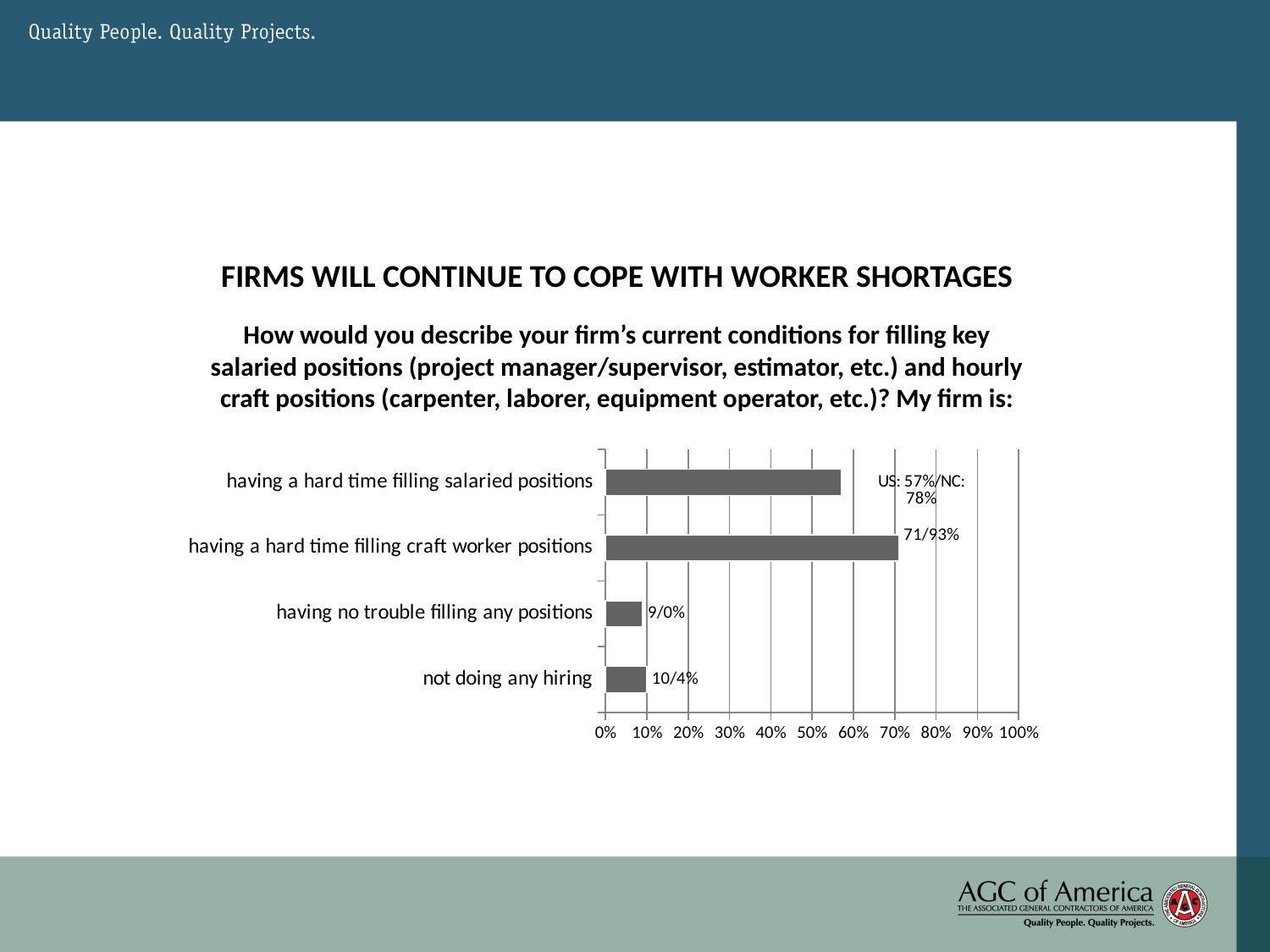
What is the highest value shown on the x axis of the chart? 100% Which bar is longer: 'having a hard time filling salaried positions' or 'having a hard time filling craft worker positions'? having a hard time filling craft worker positions What data label is shown for 'not doing any hiring'? 10/4% What data label is shown for 'having a hard time filling salaried positions'? US: 57%/NC: 78% What is the difference between the US values for 'having a hard time filling craft worker positions' (71%) and 'having a hard time filling salaried positions' (57%)? 14% What kind of chart is shown on the slide? bar chart Which category has the longest bar in the chart? having a hard time filling craft worker positions What data label is shown for 'having no trouble filling any positions'? 9/0% How many categories are plotted in the chart? 4 Which category has the shortest bar in the chart? having no trouble filling any positions What data label is shown for 'having a hard time filling craft worker positions'? 71/93% Is the bar for 'having a hard time filling salaried positions' greater or less than 50%? greater